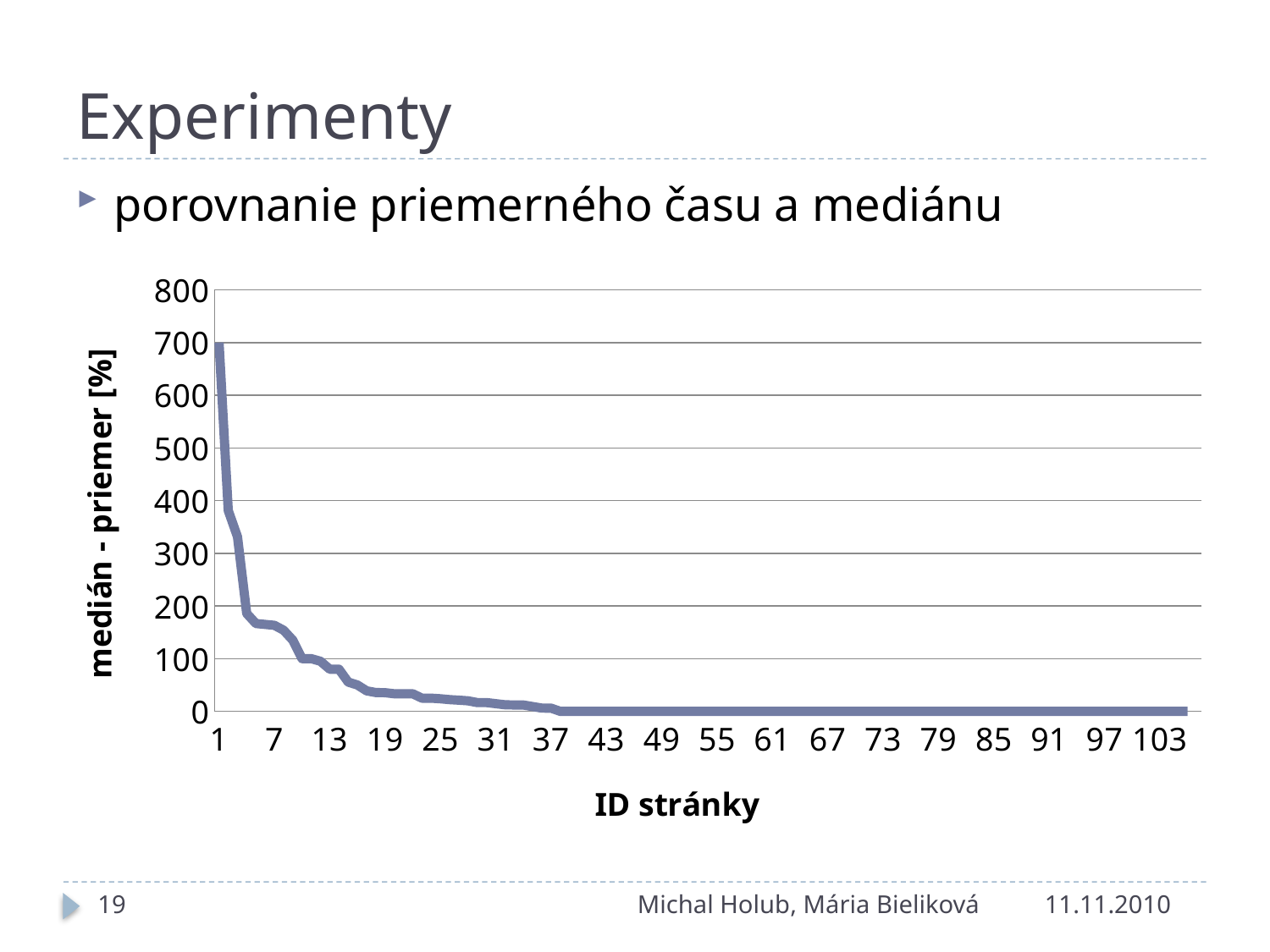
Is the value for ID stránky 7 greater or less than 100? greater What is the highest tick value shown on the y axis? 800 What kind of chart is shown on the slide? line chart Do the values rise or fall as the ID stránky increases along the x axis? fall Which has the larger value, ID stránky 1 or ID stránky 13? ID stránky 1 What is the label of the y axis? medián - priemer [%] Is the value for ID stránky 19 greater or less than 200? less Which ID stránky has the highest value of medián - priemer [%]? 1 Is the value for ID stránky 61 greater or less than 100? less What is the label of the x axis? ID stránky